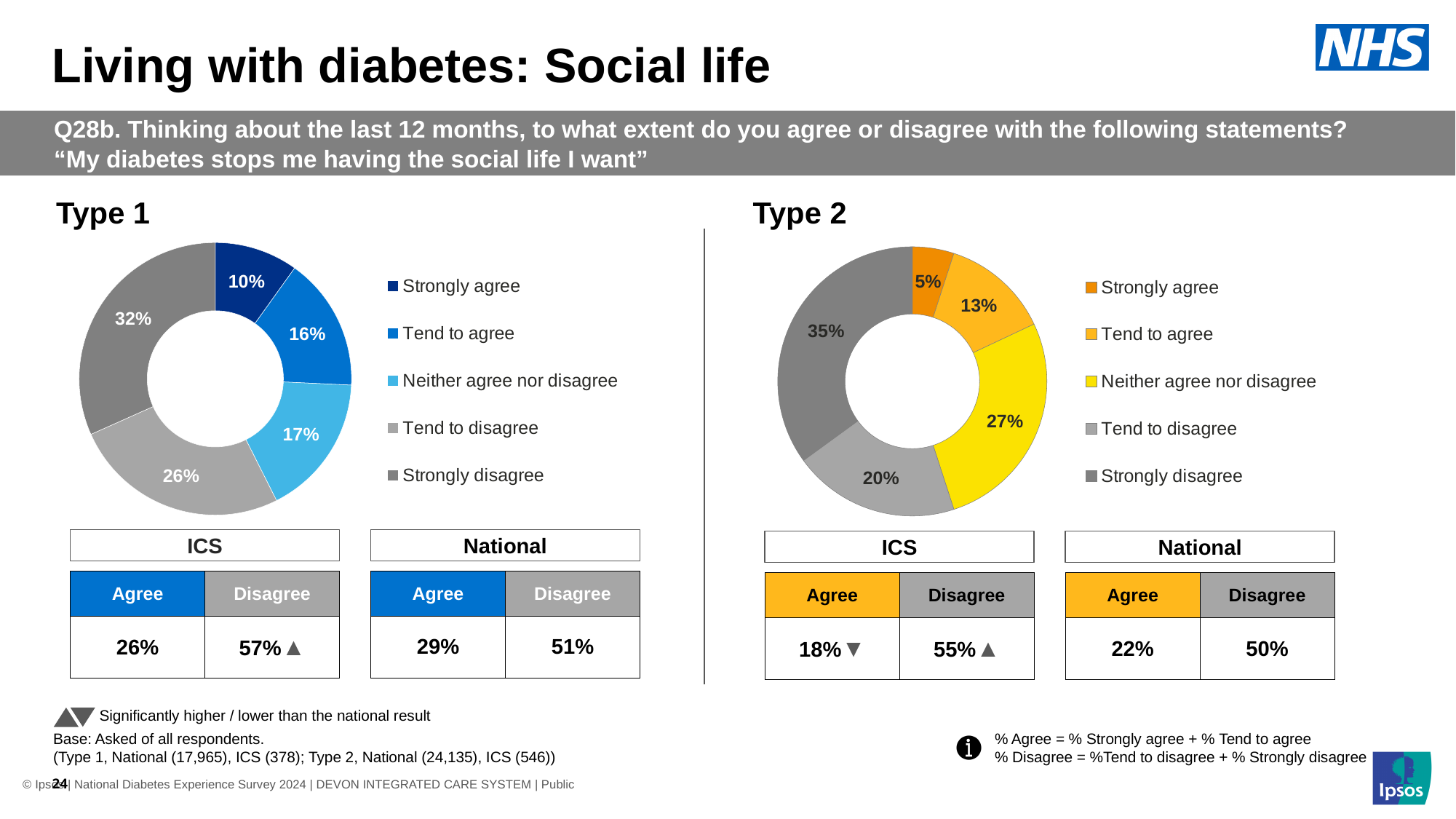
In the Type 2 chart, which is larger: the Tend to agree share or the Tend to disagree share? Tend to disagree How many response categories does the Type 1 chart's legend list? 5 In the Type 1 chart, which response category has the largest share? Strongly disagree What colour represents Neither agree nor disagree in the Type 2 chart? Yellow In the Type 2 chart, what is the combined share of Strongly agree and Tend to agree? 18% What kind of chart is used for the Type 2 data? Donut (pie) chart In the Type 1 chart, what share of the pie is Tend to agree? 16% In the Type 1 chart, what is the difference between the Strongly disagree share and the Tend to disagree share? 6 percentage points In the Type 2 chart, what percentage of respondents said they neither agree nor disagree? 27% In the Type 1 chart, what percentage of respondents said they strongly agree? 10% In the Type 2 chart, which response category has the smallest share? Strongly agree In the Type 2 chart, what percentage of respondents said they strongly disagree? 35%